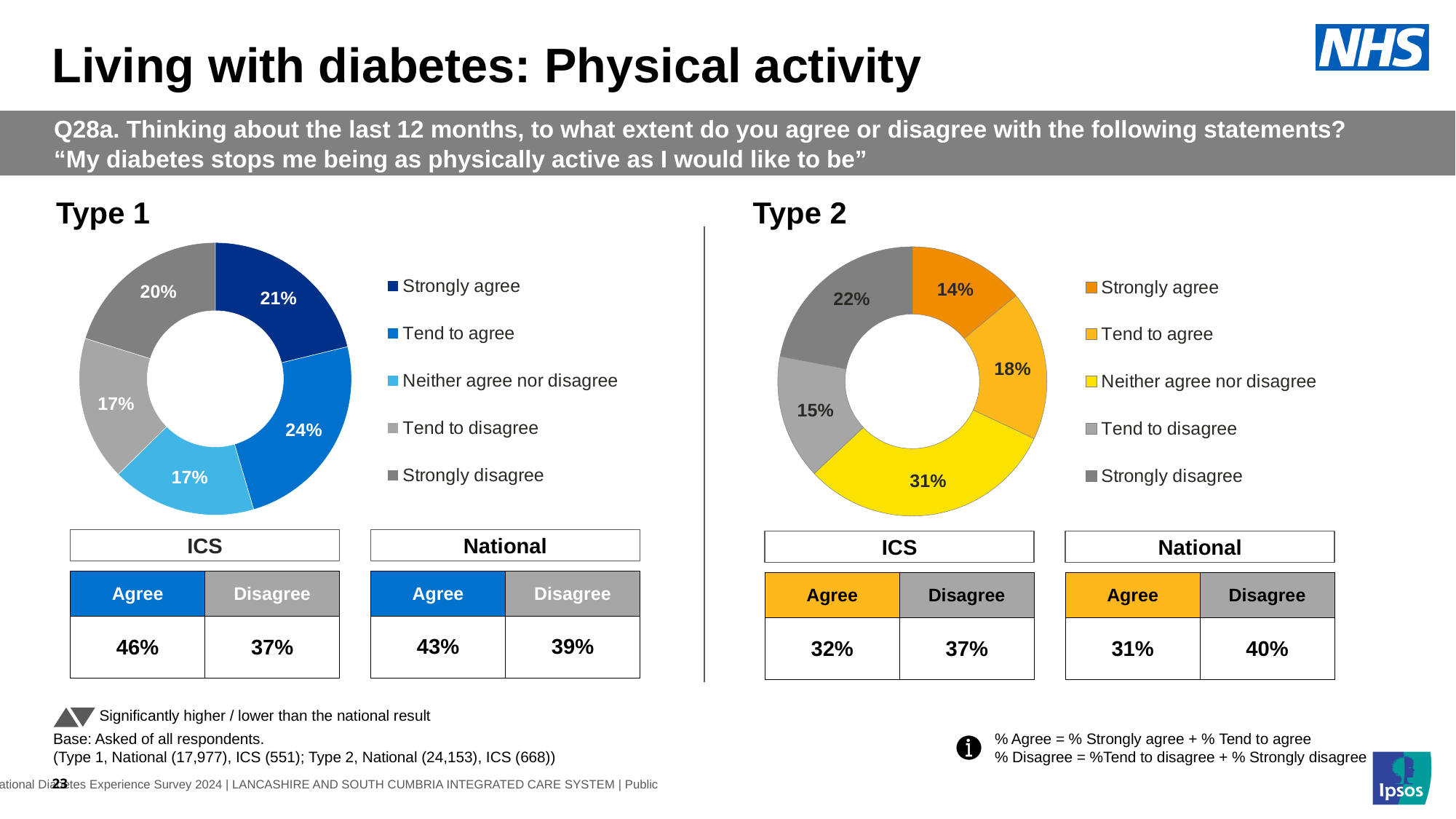
In the Type 2 chart, what is the combined share of 'Strongly agree' and 'Tend to agree'? 32% In the Type 2 chart, what is the difference in percentage points between 'Neither agree nor disagree' and 'Tend to agree'? 13 In the Type 1 chart, which response category has the largest share? Tend to agree In the Type 2 chart, what percentage of respondents said they strongly disagree? 22% In the Type 1 chart, what colour is the 'Strongly agree' segment? Dark blue What kind of chart is used to show the Type 1 results? Donut (pie) chart In the Type 1 chart, what percentage of respondents said they tend to agree? 24% In the Type 2 chart, which response category has the smallest share? Strongly agree In the Type 1 chart, which is larger: the share for 'Strongly agree' or the share for 'Strongly disagree'? Strongly agree How many response categories does the Type 2 chart show? 5 In the Type 1 chart, what percentage of respondents said they strongly agree? 21% In the Type 2 chart, what percentage of respondents said they neither agree nor disagree? 31%